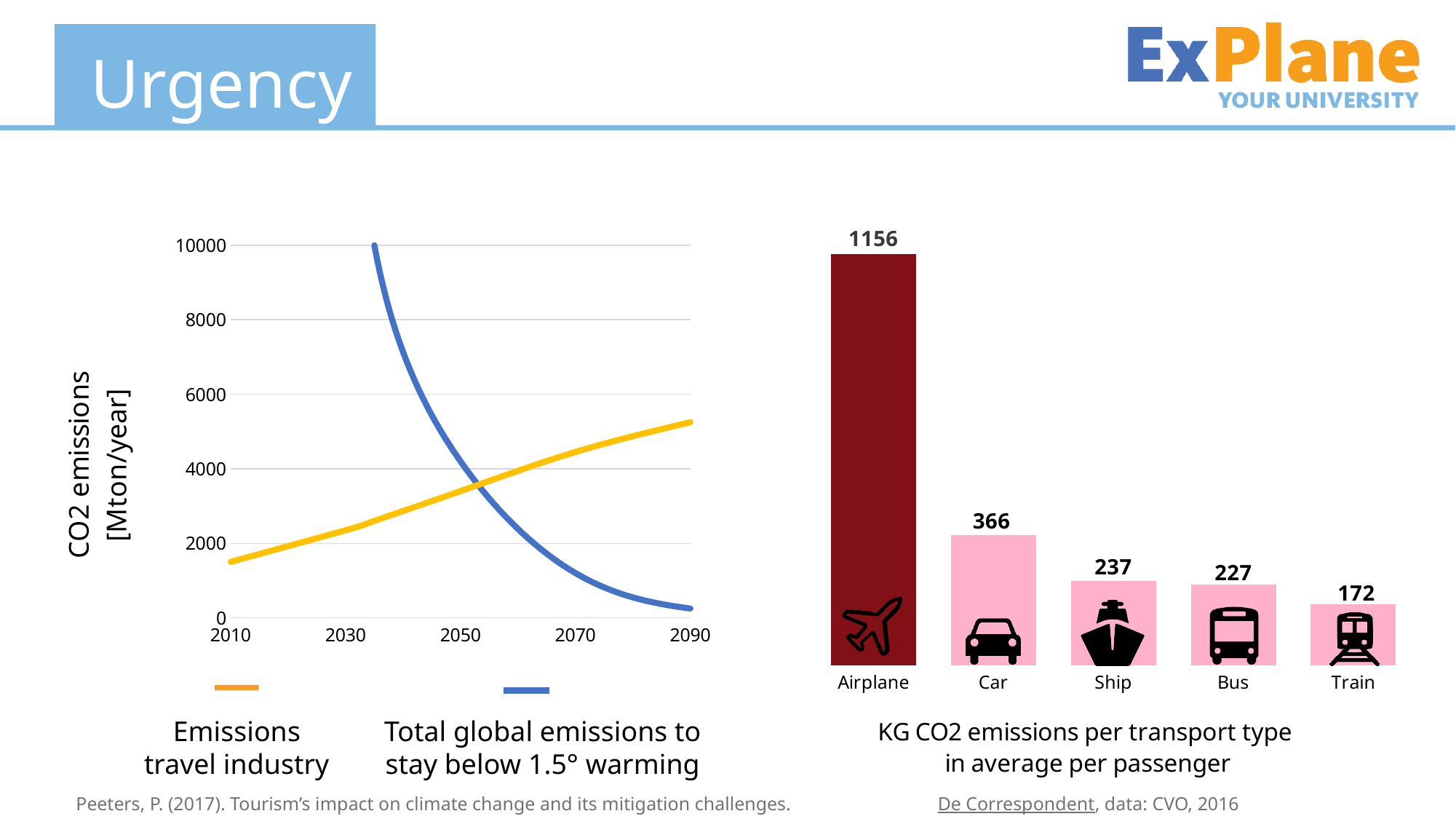
In the bar chart on the right, what is the value for Airplane? 1156 In the bar chart on the right, what is the value for Ship? 237 In the bar chart on the right, which transport type has the lowest emissions? Train In the bar chart on the right, which transport type has the highest emissions? Airplane In the bar chart on the right, what is the value for Train? 172 In the line chart on the left, does the 'Emissions travel industry' series rise or fall from 2010 to 2090? rise In the bar chart on the right, which is larger, the value for Car or the value for Bus? Car What kind of chart is the chart on the left? line chart In the bar chart on the right, what is the difference between the values for Airplane and Car? 790 How many transport types are shown in the bar chart on the right? 5 In the bar chart on the right, what is the difference between the values for Ship and Bus? 10 How many series does the legend of the line chart on the left list? 2